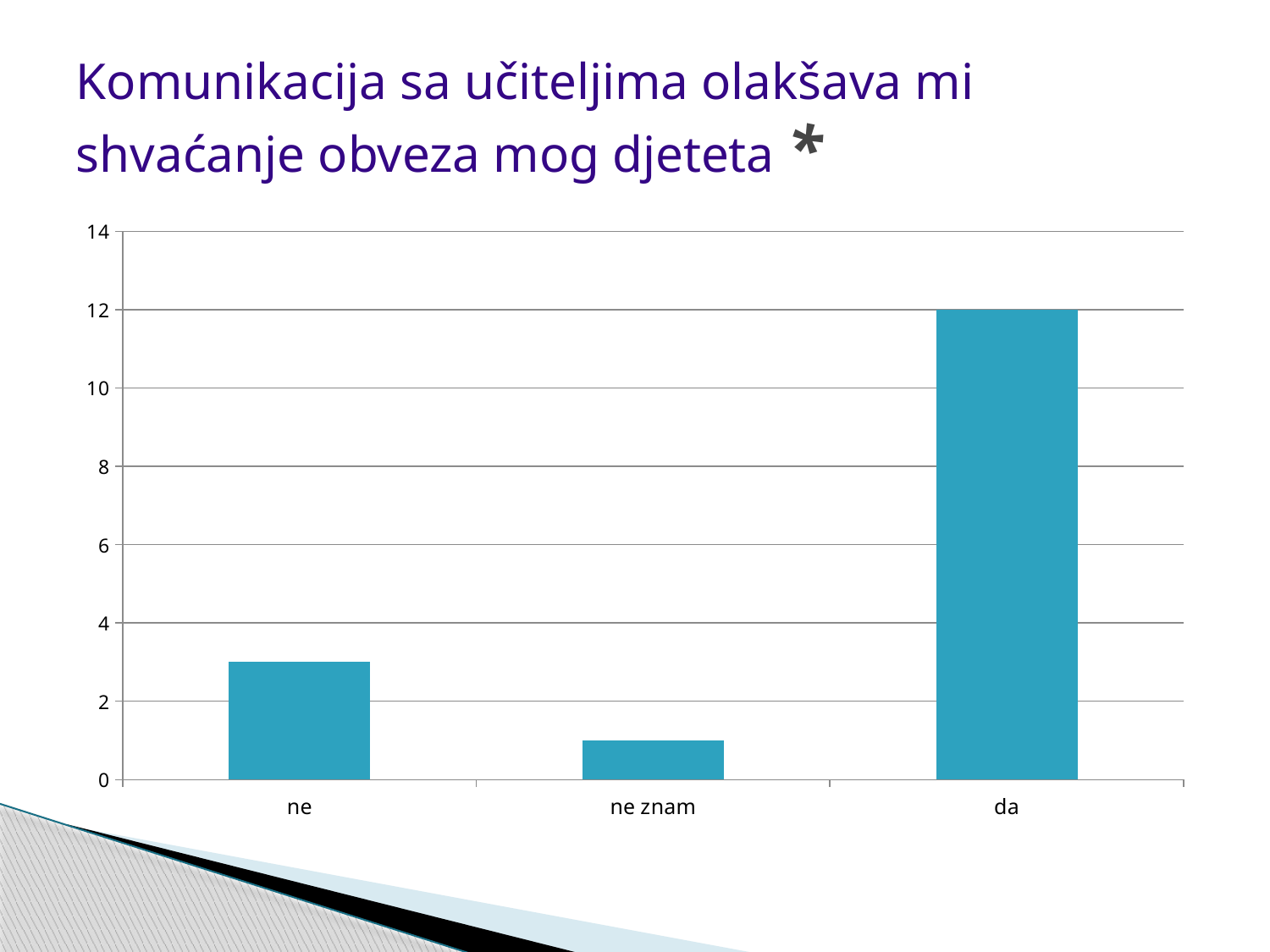
Which is larger, the value for "ne" or the value for "ne znam"? ne Which is larger, the value for "da" or the value for "ne"? da What kind of chart is shown on the slide? bar chart What is the value for "da"? 12 Is the value for "ne znam" greater or less than 2? less Which category has the highest value? da Is the value for "ne" greater or less than 4? less Is the value for "da" greater or less than 10? greater Which category has the lowest value? ne znam How many categories are shown on the x axis? 3 What is the title of the slide above the chart? Komunikacija sa učiteljima olakšava mi shvaćanje obveza mog djeteta